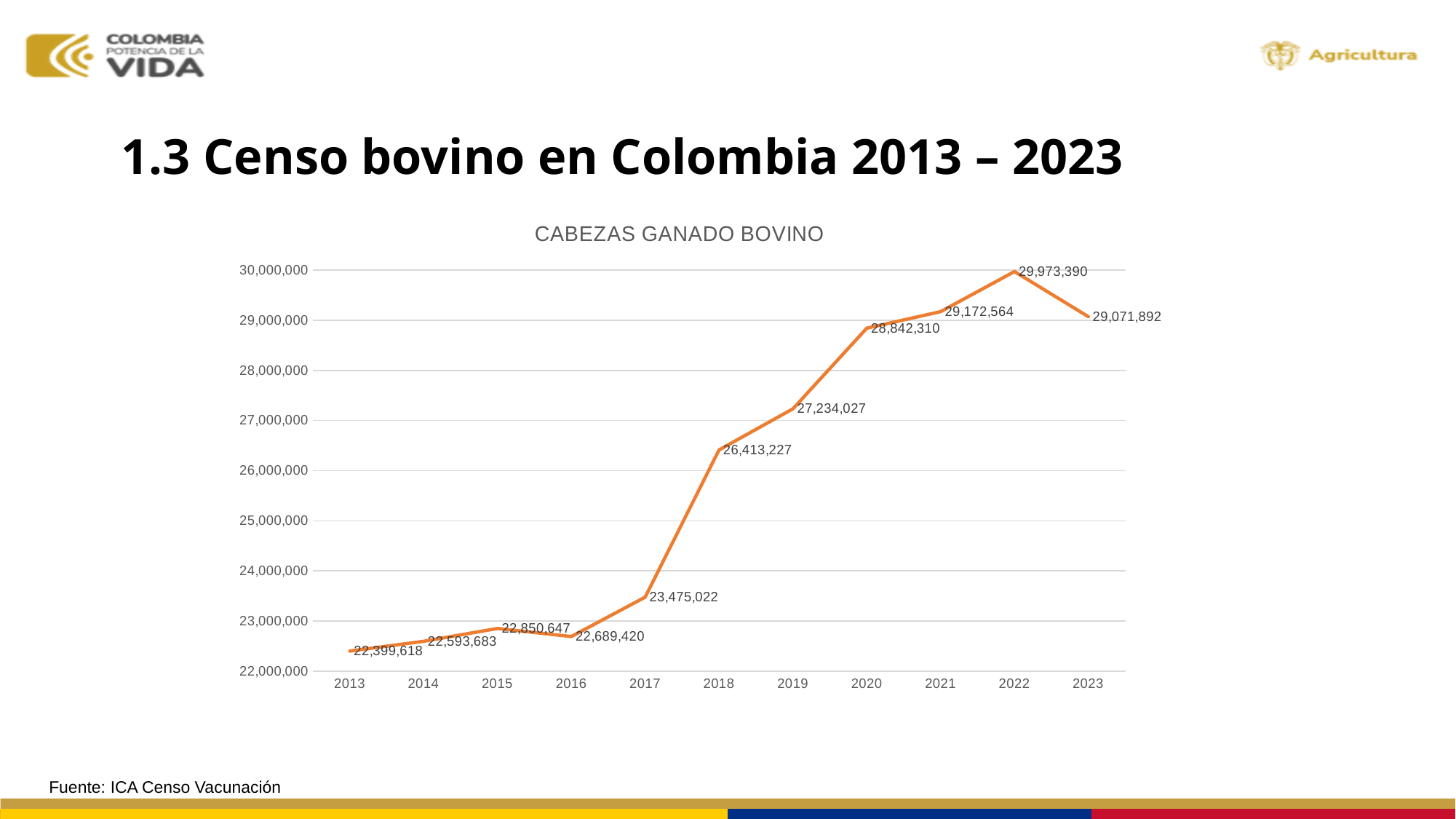
Which year has the highest value? 2022 What is the value for 2013? 22,399,618 What type of chart is shown on the slide? line chart What is the title of the chart? CABEZAS GANADO BOVINO What is the difference between the values for 2018 and 2017? 2,938,205 How many years are plotted on the chart? 11 Which year has the lowest value? 2013 Which is larger, the value for 2015 or the value for 2016? 2015 Is the value for 2019 greater or less than 27,000,000? greater What is the value for 2018? 26,413,227 What is the difference between the values for 2022 and 2023? 901,498 What is the value for 2023? 29,071,892